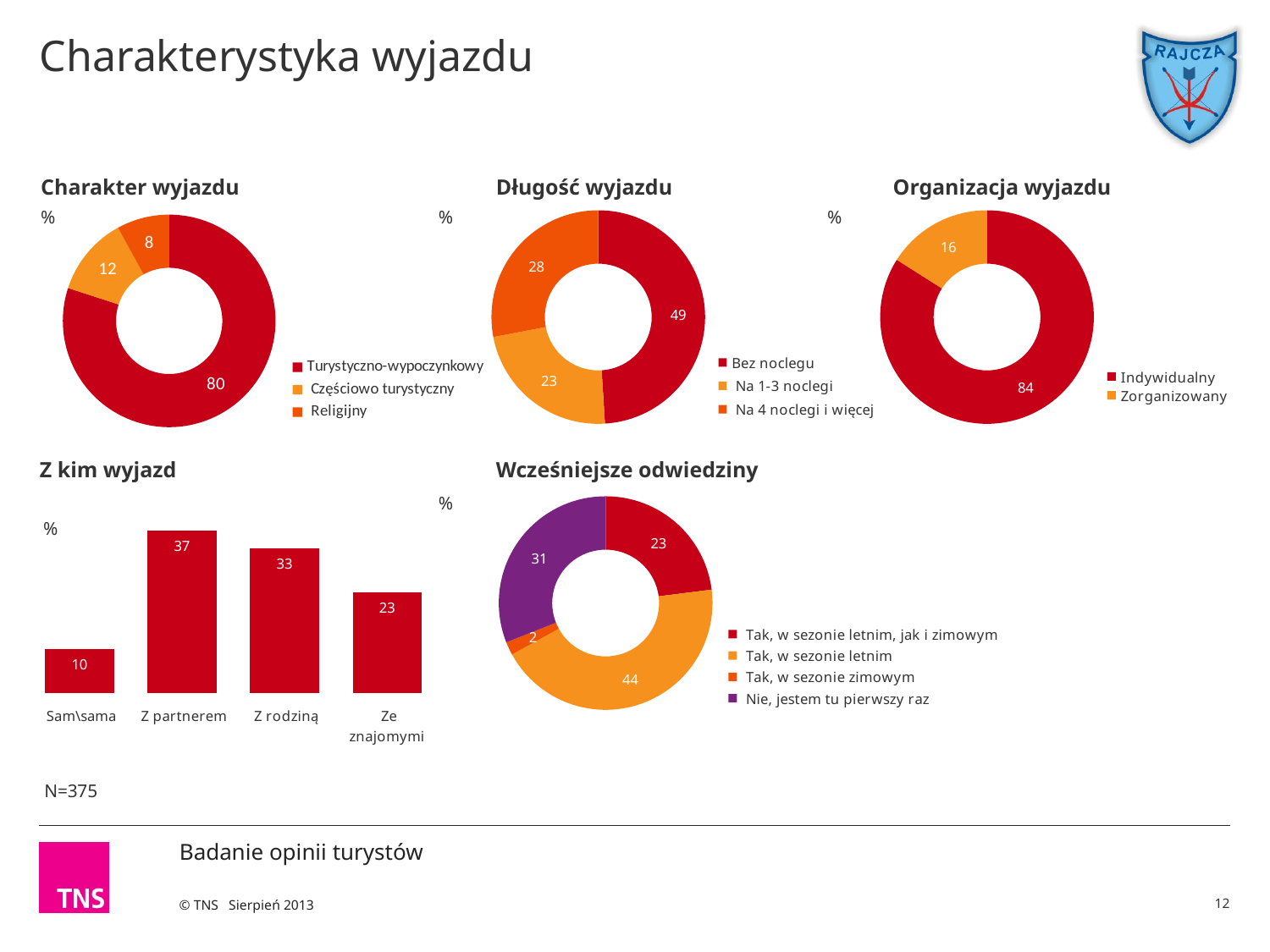
How many categories does the 'Wcześniejsze odwiedziny' chart show? 4 In the 'Organizacja wyjazdu' chart, what is the value for Indywidualny? 84 In the 'Z kim wyjazd' chart, what is the value for Z rodziną? 33 In the 'Długość wyjazdu' chart, which category has the highest value? Bez noclegu In the 'Z kim wyjazd' chart, which category has the highest value? Z partnerem In the 'Długość wyjazdu' chart, what is the difference between Bez noclegu and Na 1-3 noclegi? 26 In the 'Charakter wyjazdu' chart, what is the value for Turystyczno-wypoczynkowy? 80 In the 'Charakter wyjazdu' chart, which category has the lowest value? Religijny What kind of chart is 'Z kim wyjazd'? Bar chart In the 'Wcześniejsze odwiedziny' chart, which is larger: Tak, w sezonie letnim or Nie, jestem tu pierwszy raz? Tak, w sezonie letnim In the 'Długość wyjazdu' chart, what is the value for Na 4 noclegi i więcej? 28 How many series does the legend of the 'Organizacja wyjazdu' chart list? 2